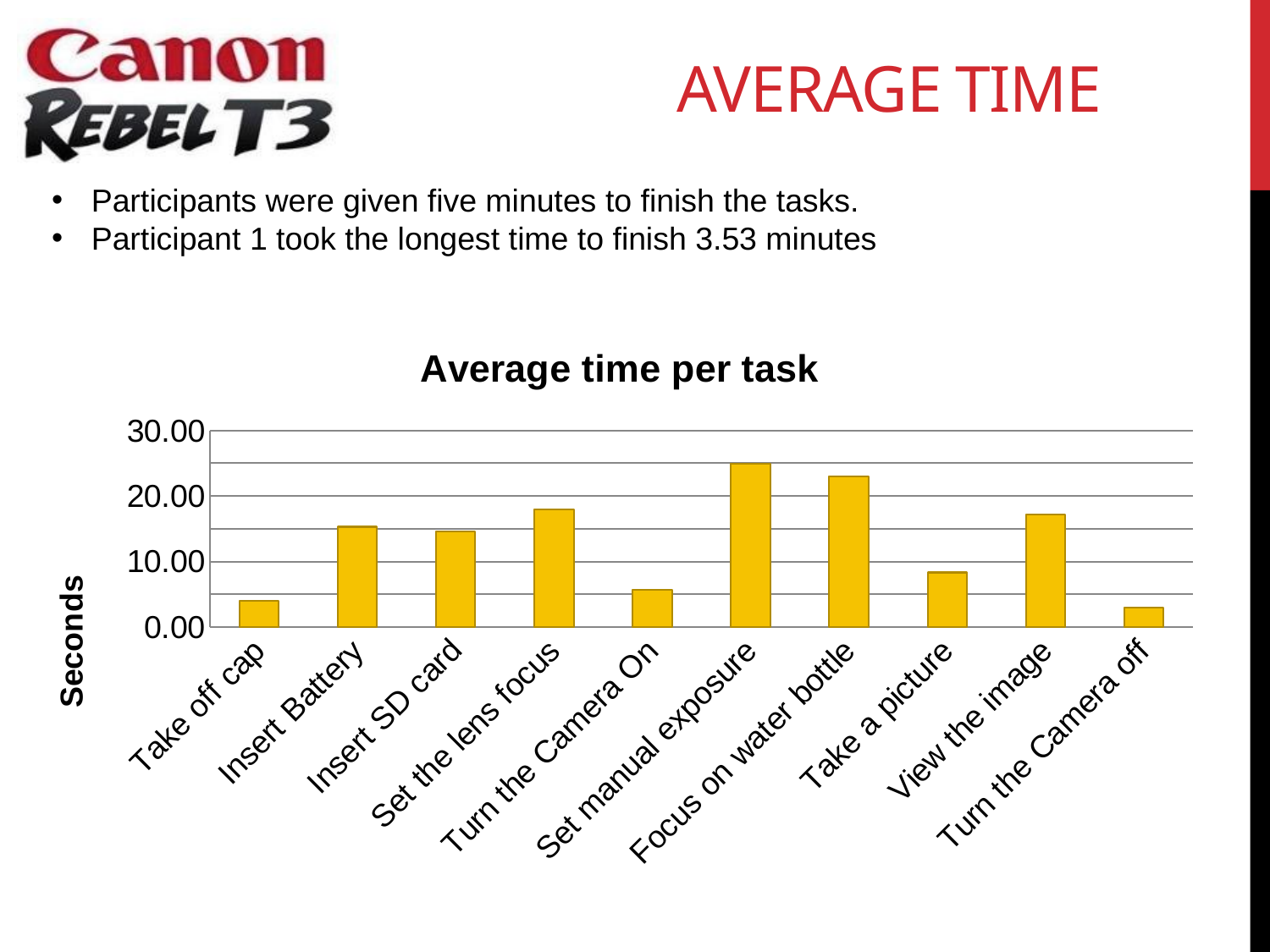
Which has a larger average time, View the image or Turn the Camera On? View the image Which task has the highest average time? Set manual exposure Is the value for Set manual exposure greater or less than 20.00? greater Is the value for Set the lens focus greater or less than 20.00? less What type of chart is shown on the slide? Bar chart What is the title of the chart? Average time per task Is the value for Take off cap greater or less than 10.00? less What is the label on the vertical axis of the chart? Seconds Which has a larger average time, Insert Battery or Take a picture? Insert Battery How many tasks are shown on the x axis of the chart? 10